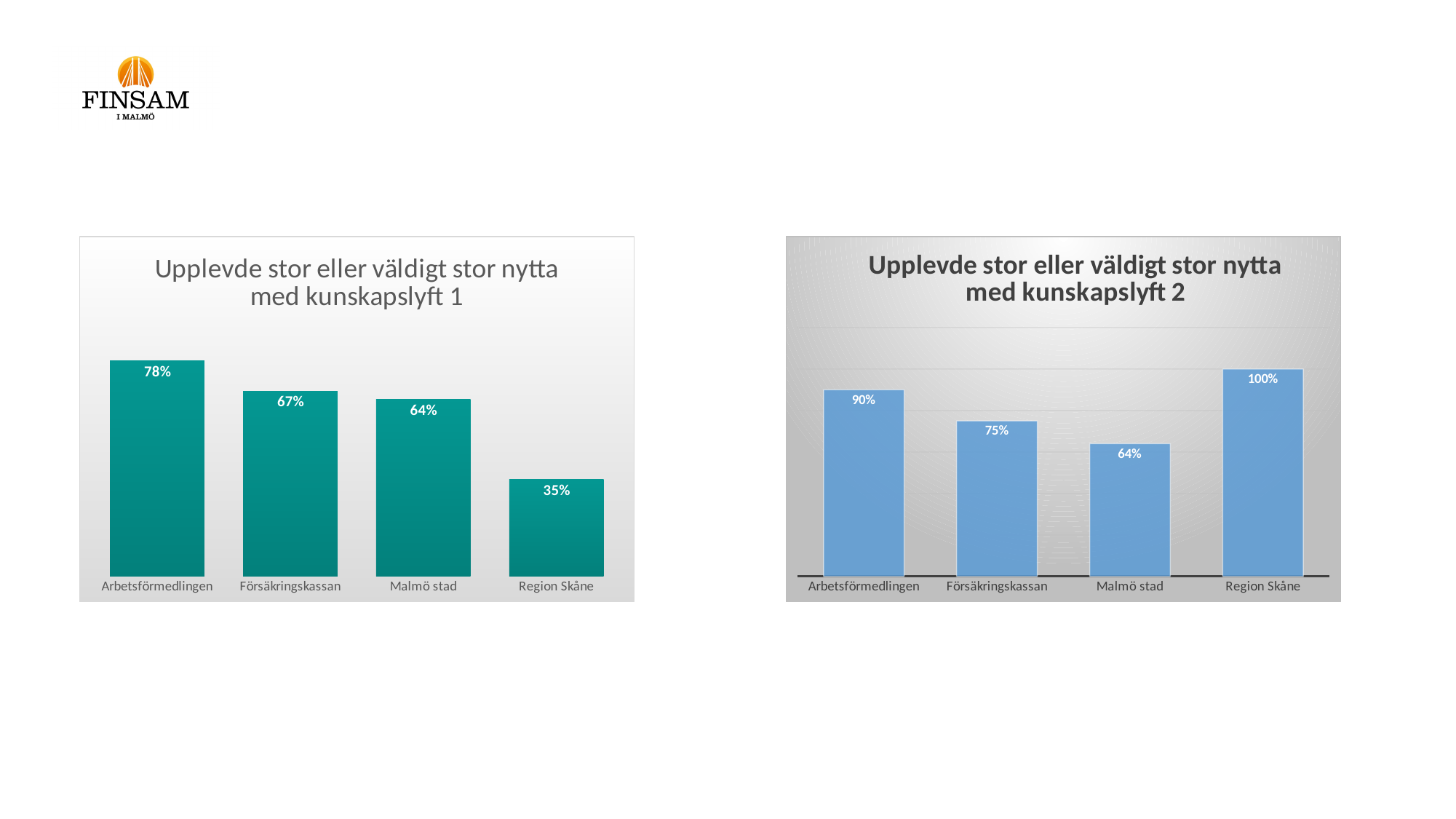
In the chart 'Upplevde stor eller väldigt stor nytta med kunskapslyft 2', what is the value for Försäkringskassan? 75% In the chart 'Upplevde stor eller väldigt stor nytta med kunskapslyft 1', what is the value for Arbetsförmedlingen? 78% In the chart 'Upplevde stor eller väldigt stor nytta med kunskapslyft 2', which category has the highest value? Region Skåne In the chart 'Upplevde stor eller väldigt stor nytta med kunskapslyft 1', what is the value for Region Skåne? 35% In the chart 'Upplevde stor eller väldigt stor nytta med kunskapslyft 2', which category has the lowest value? Malmö stad In the chart 'Upplevde stor eller väldigt stor nytta med kunskapslyft 1', what is the difference between the values for Arbetsförmedlingen and Region Skåne? 43% In the chart 'Upplevde stor eller väldigt stor nytta med kunskapslyft 2', what is the value for Malmö stad? 64% In the chart 'Upplevde stor eller väldigt stor nytta med kunskapslyft 1', which is larger, the value for Försäkringskassan or the value for Malmö stad? Försäkringskassan In the chart 'Upplevde stor eller väldigt stor nytta med kunskapslyft 1', which category has the highest value? Arbetsförmedlingen How many categories are shown in the chart 'Upplevde stor eller väldigt stor nytta med kunskapslyft 2'? 4 What kind of chart is 'Upplevde stor eller väldigt stor nytta med kunskapslyft 1'? Bar chart In the chart 'Upplevde stor eller väldigt stor nytta med kunskapslyft 2', what is the difference between the values for Region Skåne and Arbetsförmedlingen? 10%